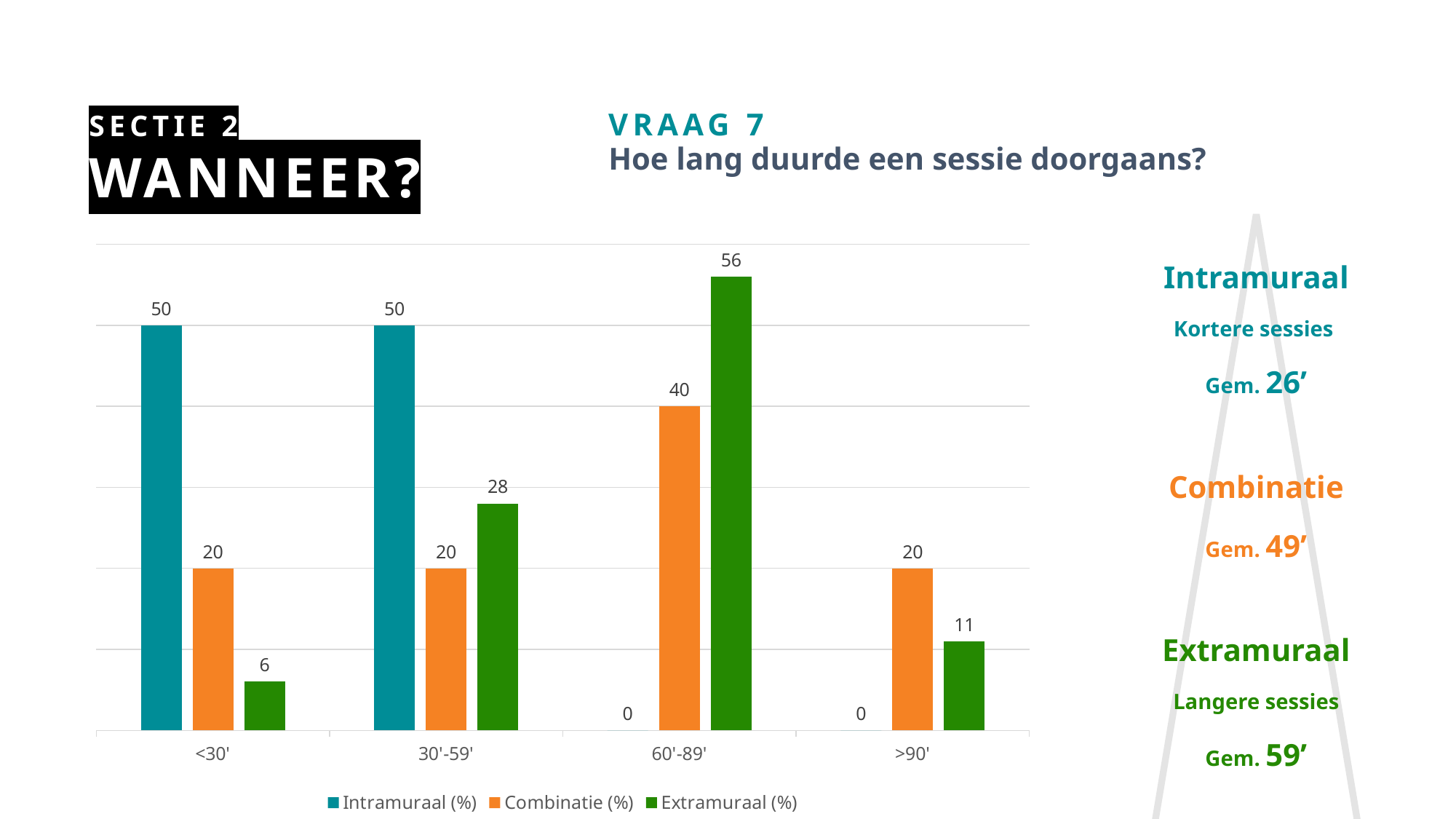
What is the value for Combinatie (%) in the >90' category? 20 What is the value for Extramuraal (%) in the 60'-89' category? 56 What is the value for Intramuraal (%) in the 60'-89' category? 0 Which is larger in the 30'-59' category: Intramuraal (%) or Extramuraal (%)? Intramuraal (%) How many series does the legend list? 3 Which series is shown in orange in the legend? Combinatie (%) How many categories are shown on the x axis? 4 What kind of chart is shown on the slide? Bar chart What is the difference between Extramuraal (%) and Combinatie (%) in the 60'-89' category? 16 Which category has the highest value for Extramuraal (%)? 60'-89' Which category has the lowest value for Extramuraal (%)? <30' What is the value for Intramuraal (%) in the <30' category? 50